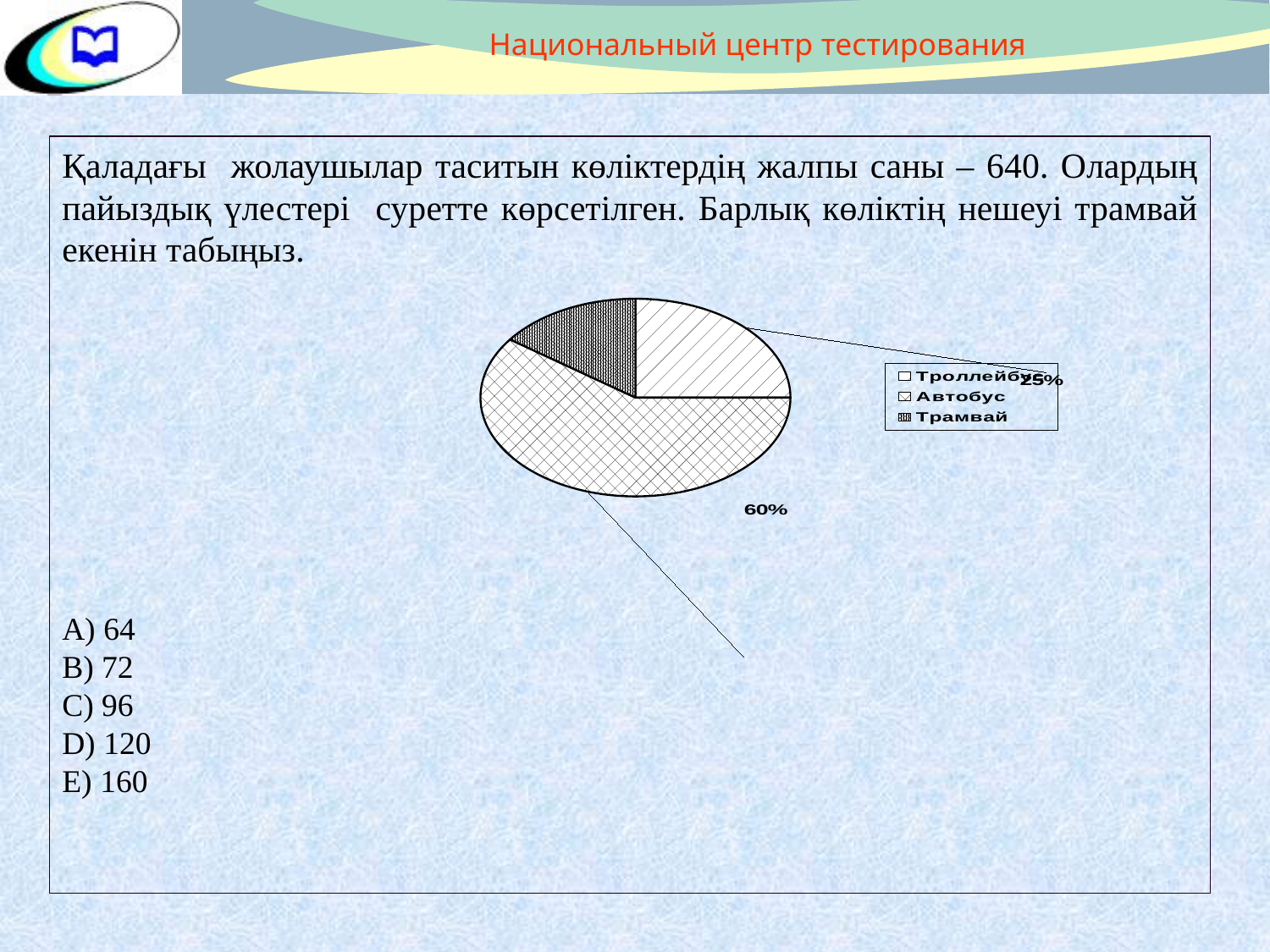
What percentage share is labelled for Автобус in the pie chart? 60% By how many percentage points does the Автобус share exceed the Троллейбус share? 35% Which slice is larger in the pie chart, Троллейбус or Трамвай? Троллейбус What kind of chart is shown on the slide? pie chart Which category has the largest slice in the pie chart? Автобус Which slice is larger in the pie chart, Автобус or Троллейбус? Автобус How many categories does the legend of the pie chart list? 3 Which categories are listed in the legend of the pie chart? Троллейбус, Автобус, Трамвай Which category in the legend is shown with a cross-hatched pattern? Автобус What percentage share is labelled for Троллейбус in the pie chart? 25% Which category has the smallest slice in the pie chart? Трамвай